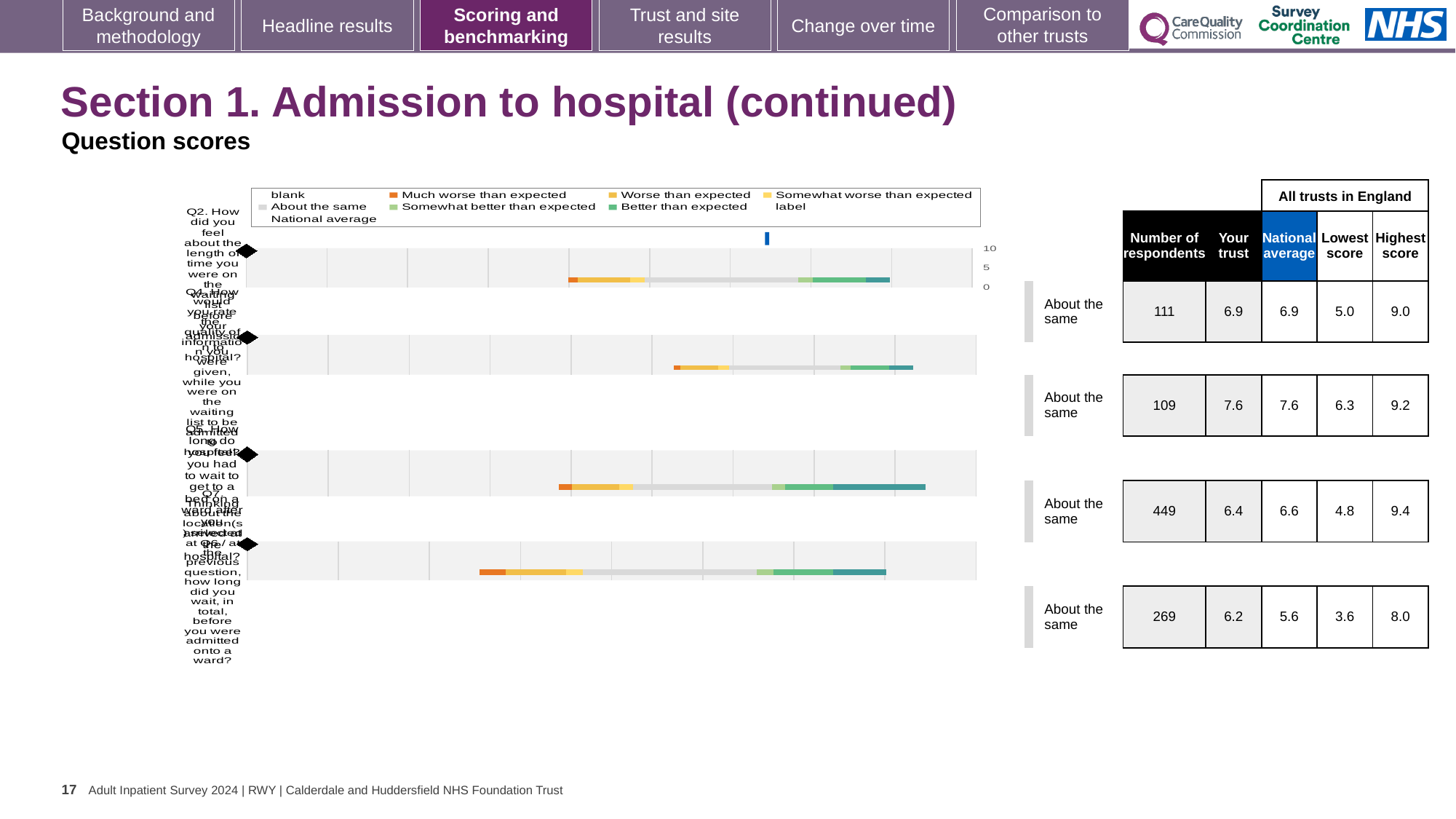
What is the national average score for the first question row (Q2)? 6.9 What kind of chart is shown on the slide? bar chart What is the highest value shown on the chart's score axis? 10 For the third question row (Q5), which is larger: the 'Your trust' score or the national average? National average What is the 'Your trust' score for the fourth question row (Q7)? 6.2 Which question row has the highest number of respondents? the third row (Q5), 449 What is the highest score across all trusts in England for the second question row (Q4)? 9.2 Which question row has the lowest 'Lowest score' value? the fourth row (Q7), 3.6 How many question rows are plotted in the chart? 4 What is the number of respondents for the first question row (Q2)? 111 What benchmark category is shown next to every question row in the chart? About the same For the fourth question row (Q7), what is the difference between the 'Your trust' score and the national average? 0.6